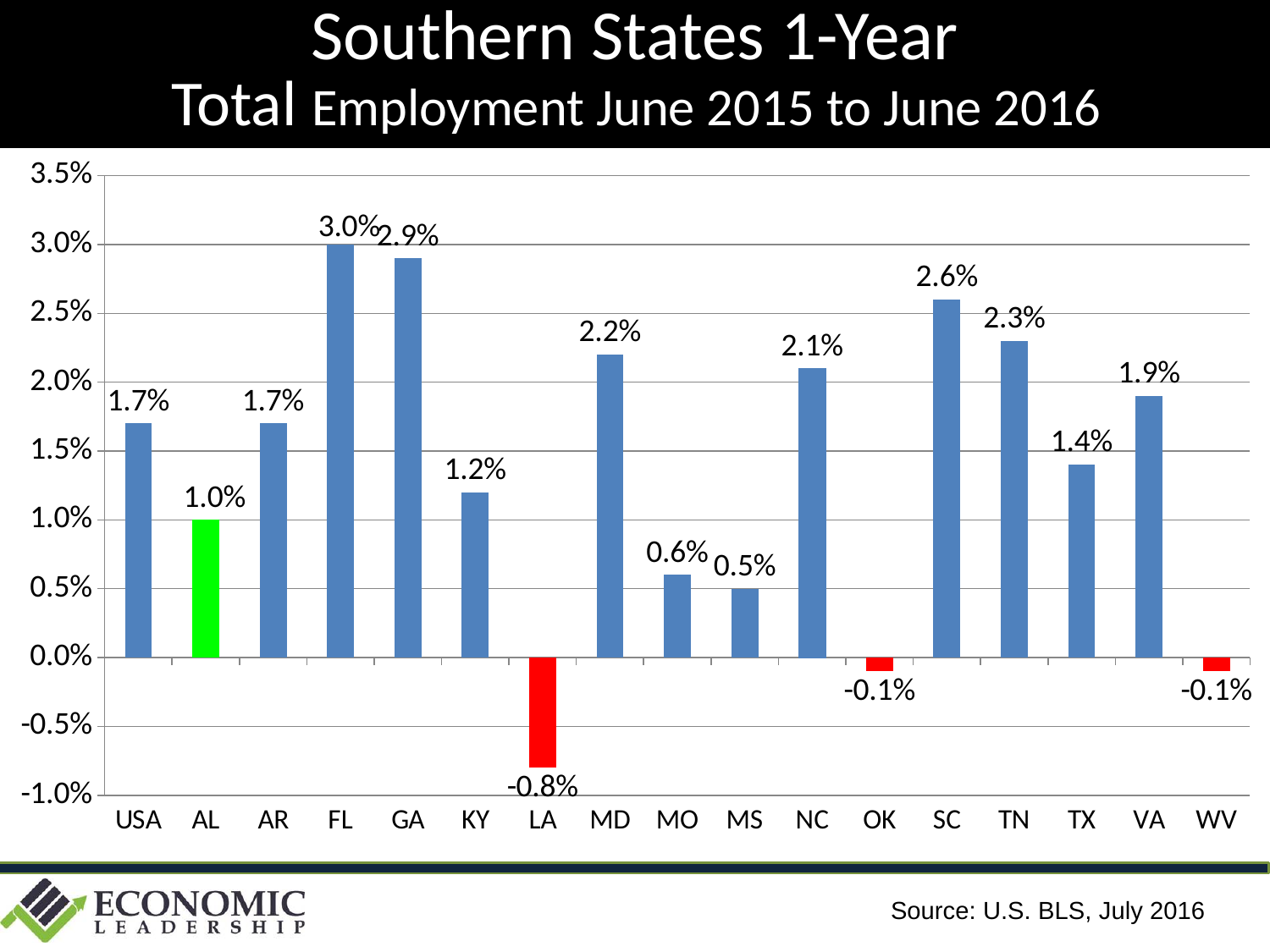
What kind of chart is this? bar chart What is the difference between the values for FL and AL? 2.0% What is the value for AL? 1.0% Which is larger, the value for NC or the value for TX? NC What is the value for SC? 2.6% How many categories are shown on the x axis? 17 What is the value for FL? 3.0% What is the value for LA? -0.8% Is the value for MD greater or less than 2.0%? greater Which category has the highest value? FL Which category has the lowest value? LA Which bar is coloured green? AL